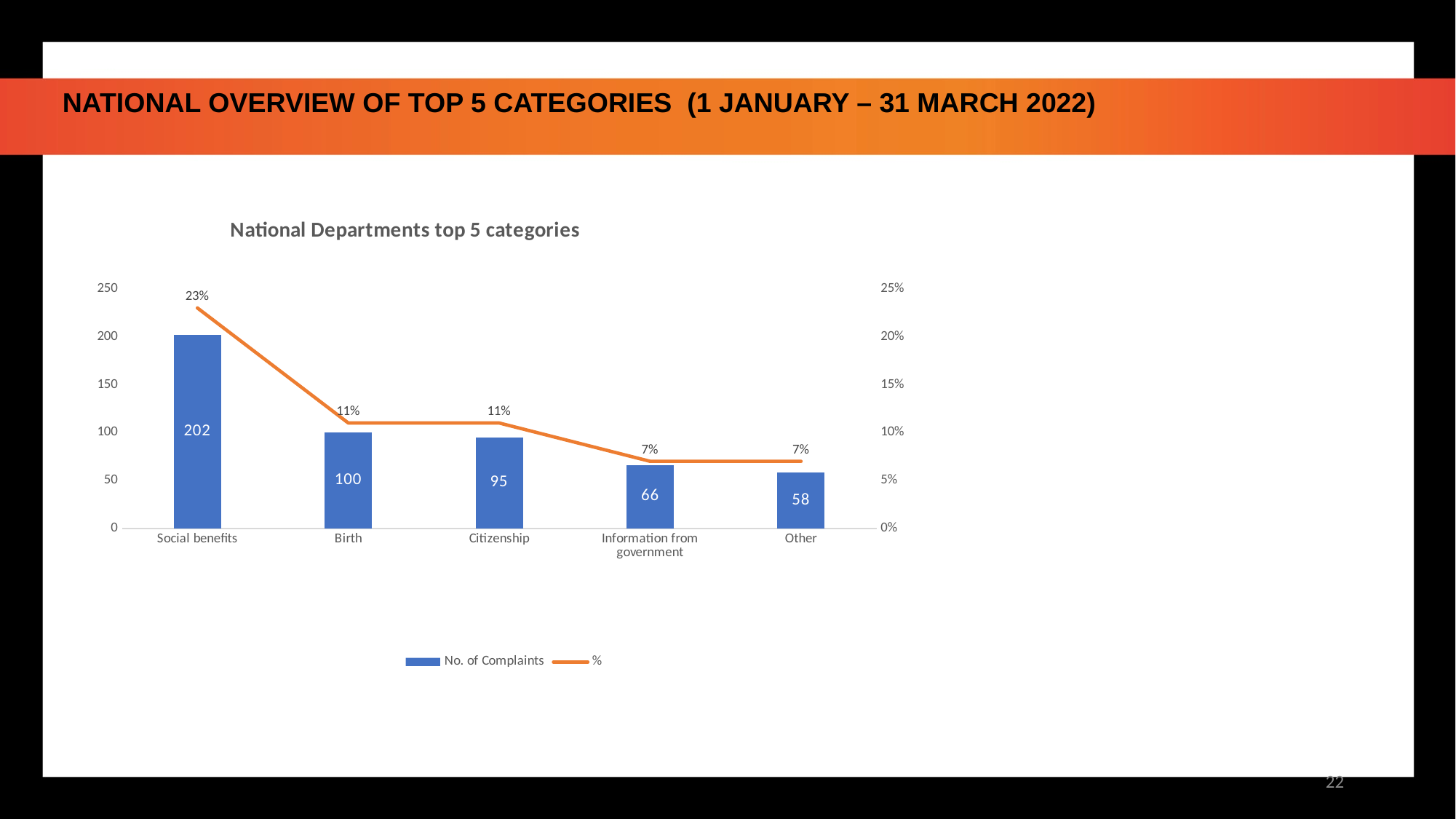
Which category has the highest number of complaints? Social benefits What is the number of complaints for Citizenship? 95 What percentage is shown for Birth? 11% What percentage is shown for Information from government? 7% Which has more complaints, Information from government or Other? Information from government What is the title of the chart? National Departments top 5 categories How many series does the legend list? 2 What is the number of complaints for Social benefits? 202 How many categories are shown on the x axis? 5 What is the difference in the number of complaints between Social benefits and Birth? 102 Do the number of complaints rise or fall from left to right along the x axis? fall Which category has the lowest number of complaints? Other